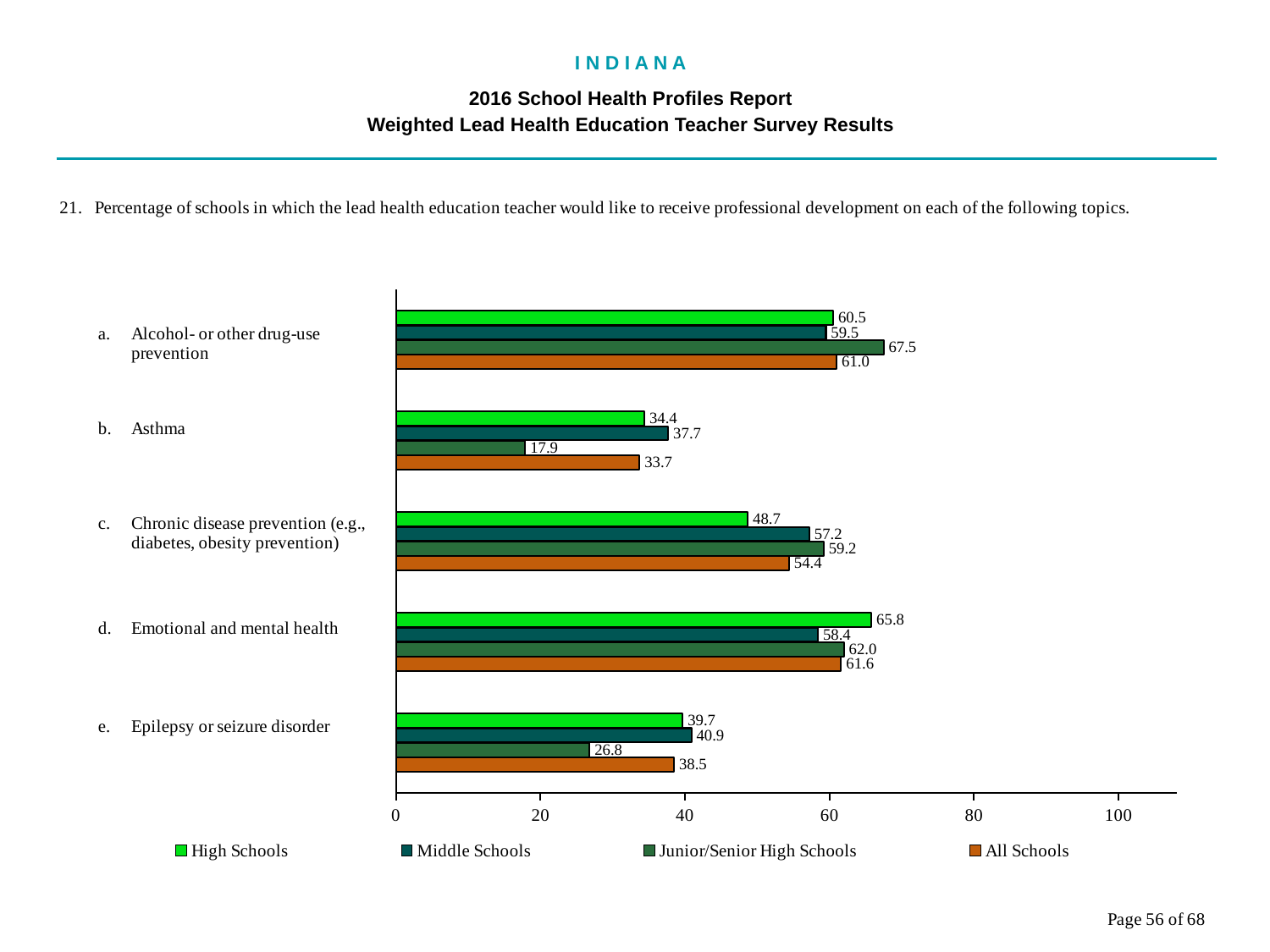
Which series is shown in orange in the legend? All Schools What kind of chart is shown on the slide? bar chart What is the value for High Schools for Emotional and mental health? 65.8 Which topic has the highest All Schools value? Emotional and mental health Which topic has the lowest Middle Schools value? Asthma What is the difference between the Junior/Senior High Schools and High Schools values for Alcohol- or other drug-use prevention? 7.0 How many topics are shown on the chart? 5 Is the Junior/Senior High Schools value for Epilepsy or seizure disorder greater or less than 40? less Which is larger for Chronic disease prevention: the High Schools value or the Middle Schools value? Middle Schools What is the value for Junior/Senior High Schools for Asthma? 17.9 What is the All Schools value for Epilepsy or seizure disorder? 38.5 How many series does the legend list? 4